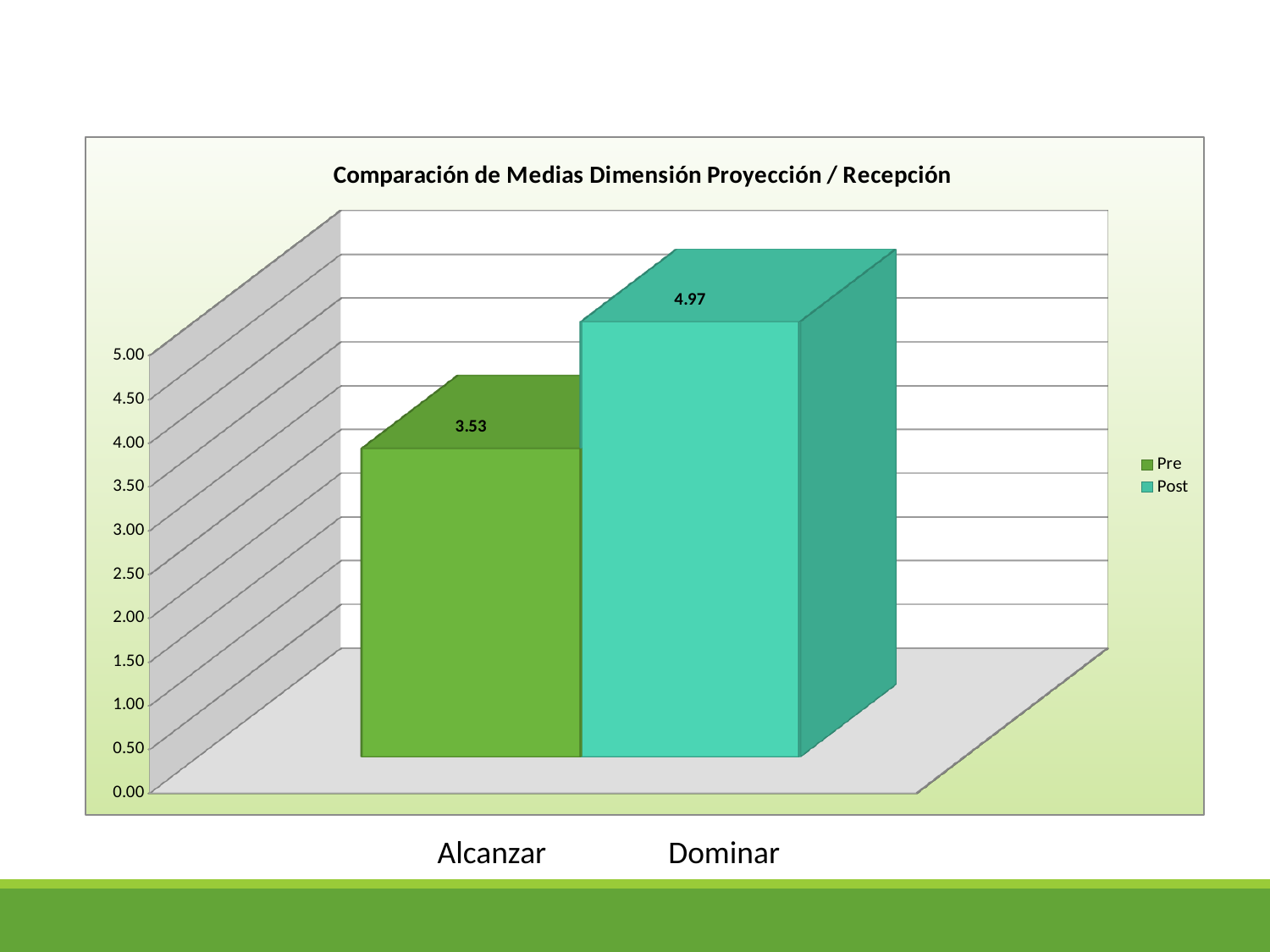
What is the value of the Post bar? 4.97 What is the difference between the Post value and the Pre value? 1.44 Is the value for Post greater or less than 4.00? greater How many bars are plotted in the chart? 2 Which series has the lower value, Pre or Post? Pre What is the title of the chart? Comparación de Medias Dimensión Proyección / Recepción What is the value of the Pre bar? 3.53 Which series has the higher value, Pre or Post? Post What kind of chart is shown on the slide? bar chart How many series does the legend list? 2 Is the value for Pre greater or less than 4.00? less Is the Pre value larger or smaller than the Post value? smaller